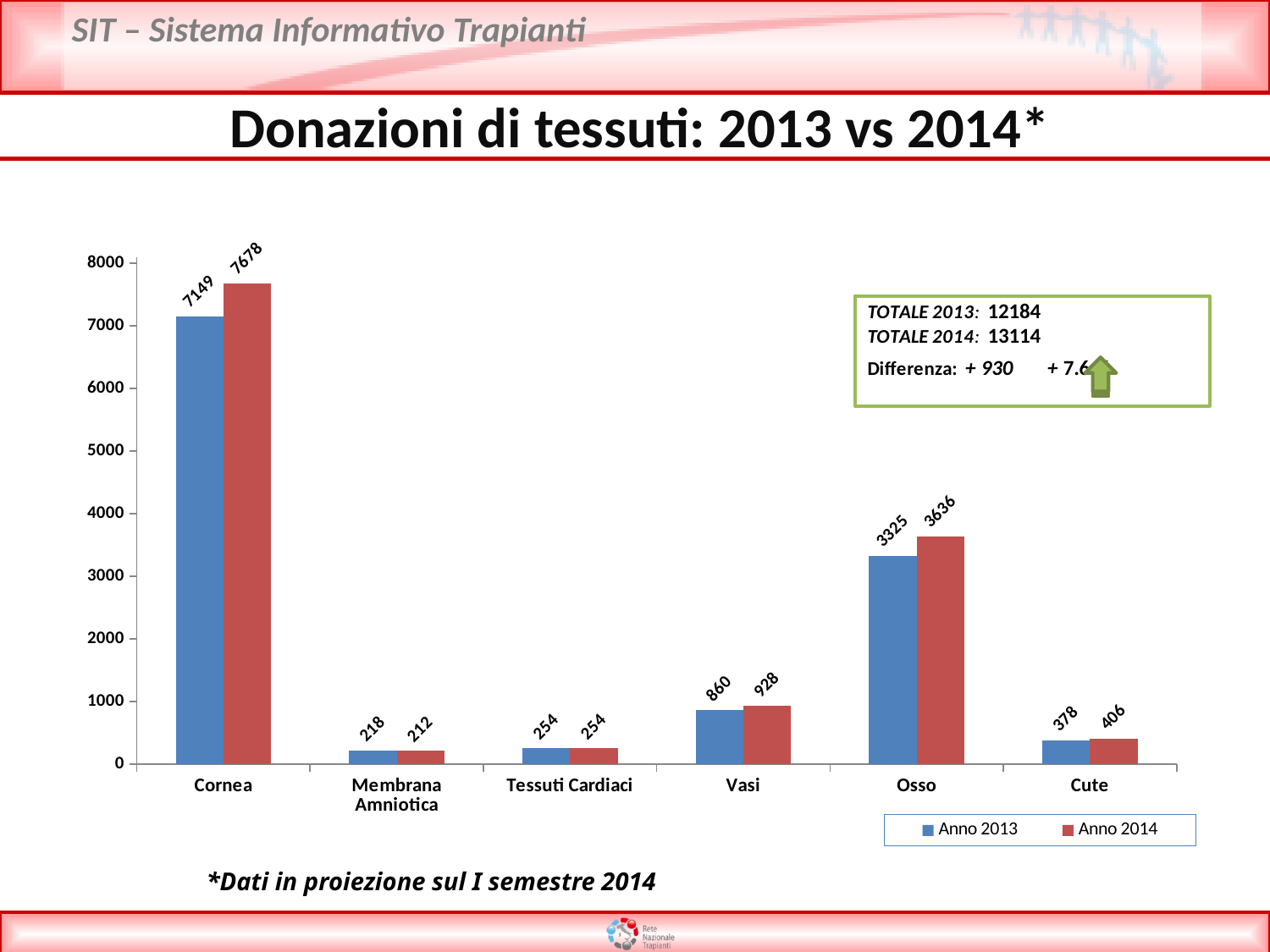
Which category has the highest value in Anno 2013? Cornea How many series does the legend list? 2 What is the difference between the Anno 2014 and Anno 2013 values for Osso? 311 Is the value for Vasi in Anno 2013 greater or less than 1000? less What is the value for Cornea in Anno 2014? 7678 What is the title of the chart on the slide? Donazioni di tessuti: 2013 vs 2014* What is the value for Vasi in Anno 2014? 928 Which is larger for Cute: the Anno 2013 value or the Anno 2014 value? Anno 2014 Which category has the lowest value in Anno 2014? Membrana Amniotica What is the value for Osso in Anno 2013? 3325 What kind of chart is shown on the slide? bar chart How many categories are shown on the x axis? 6